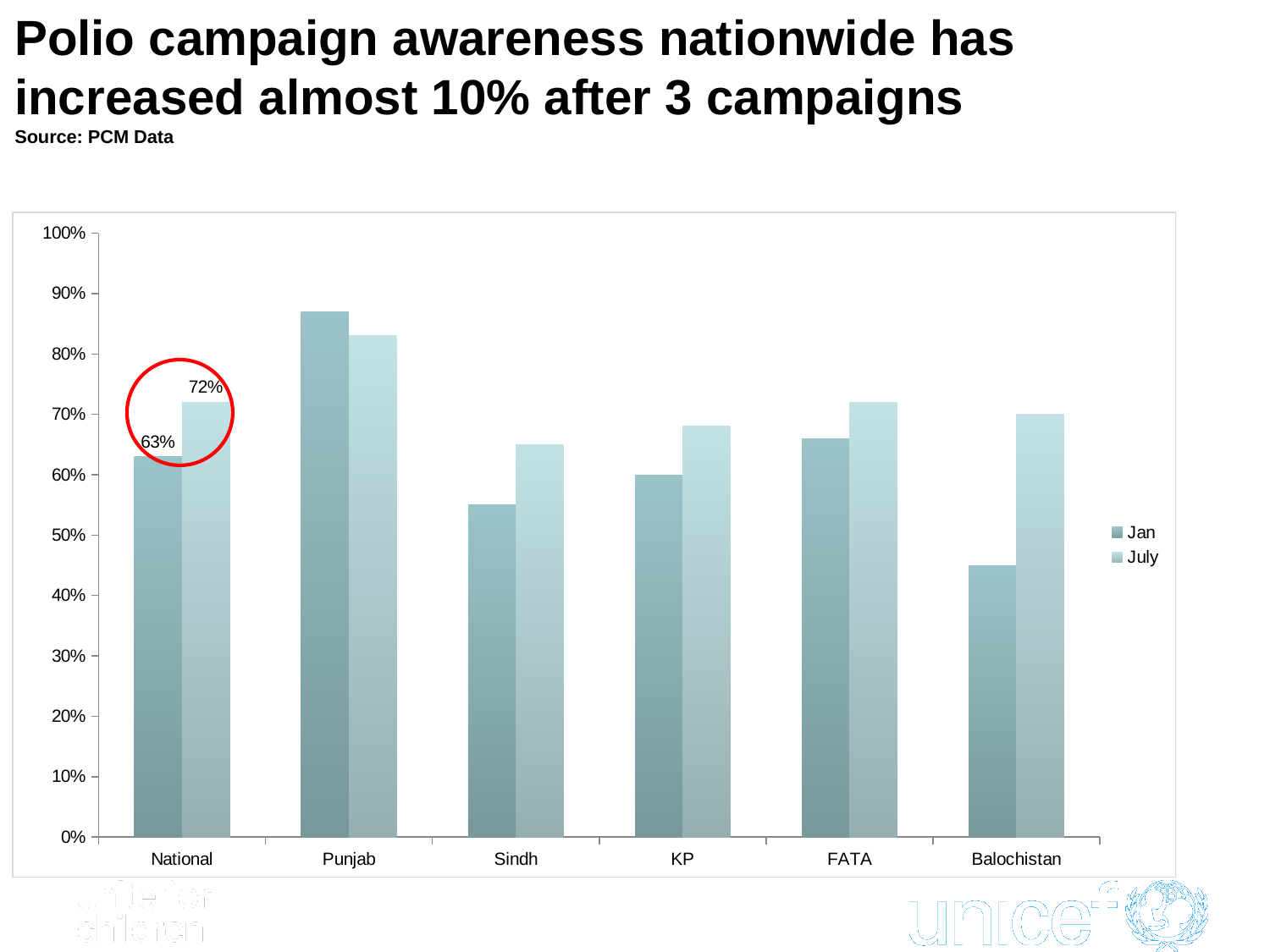
How many series does the legend list? 2 Is the Jan value for Balochistan greater or less than 50%? less What is the July value for National? 72% What is the difference between the July and Jan values for National? 9% Is the Jan value for Punjab greater or less than 80%? greater What is the Jan value for National? 63% For National, which is larger, the Jan value or the July value? July What kind of chart is shown on the slide? bar chart Which category has the highest Jan value? Punjab How many categories are shown on the x axis? 6 Which category has the lowest Jan value? Balochistan Is the July value for KP greater or less than 60%? greater